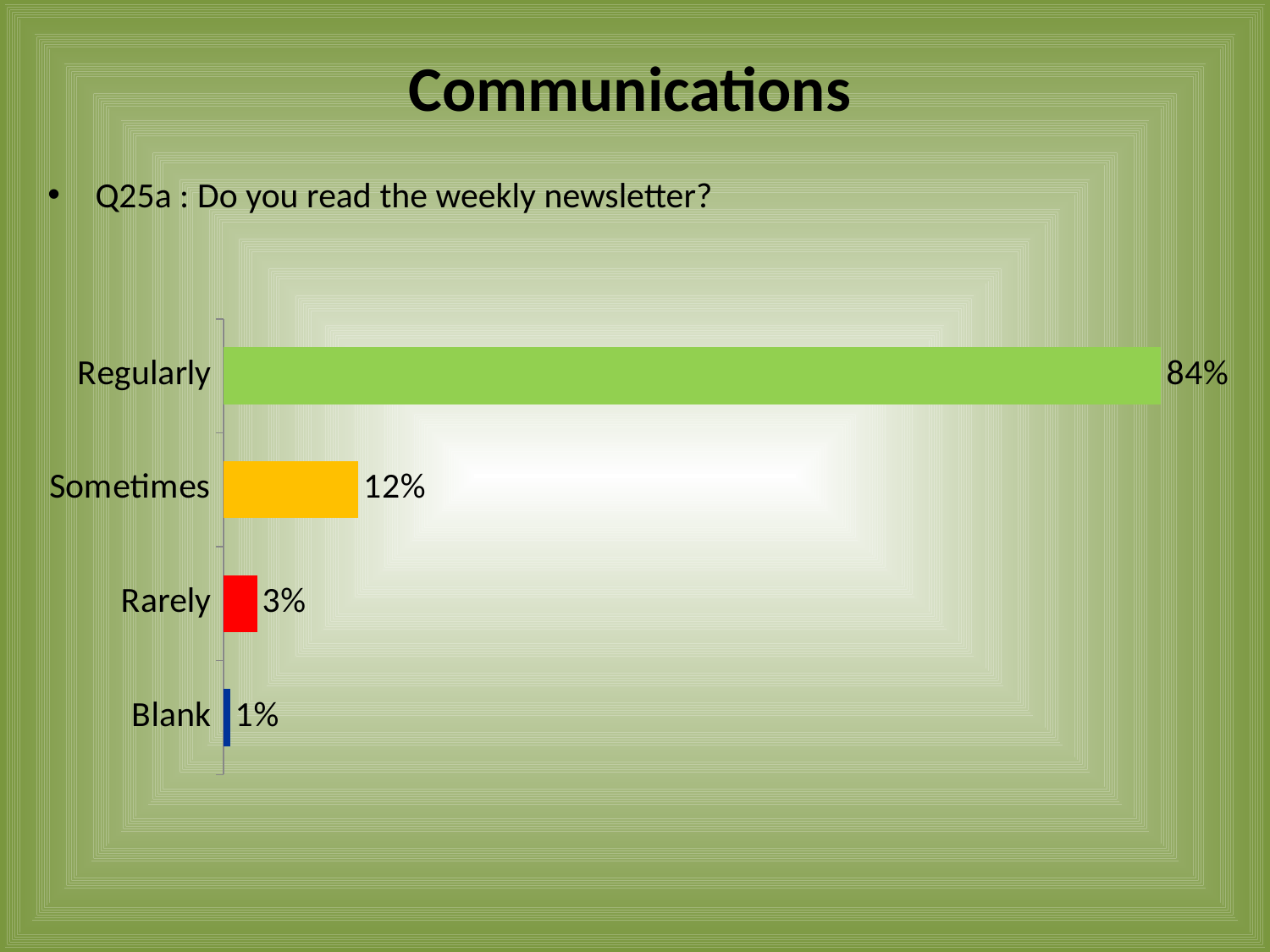
What percentage of respondents read the weekly newsletter regularly? 84% What kind of chart is shown on the slide? Bar chart Which is larger, the value for Rarely or the value for Blank? Rarely How many categories are shown in the chart? 4 What is the value shown for the Sometimes category? 12% What is the difference between the Regularly and Sometimes values? 72% What is the difference between the Sometimes and Rarely values? 9% What colour is the bar for the Rarely category? Red Which category has the lowest value? Blank Which category has the highest value? Regularly What is the value shown for the Blank category? 1% What is the value shown for the Rarely category? 3%